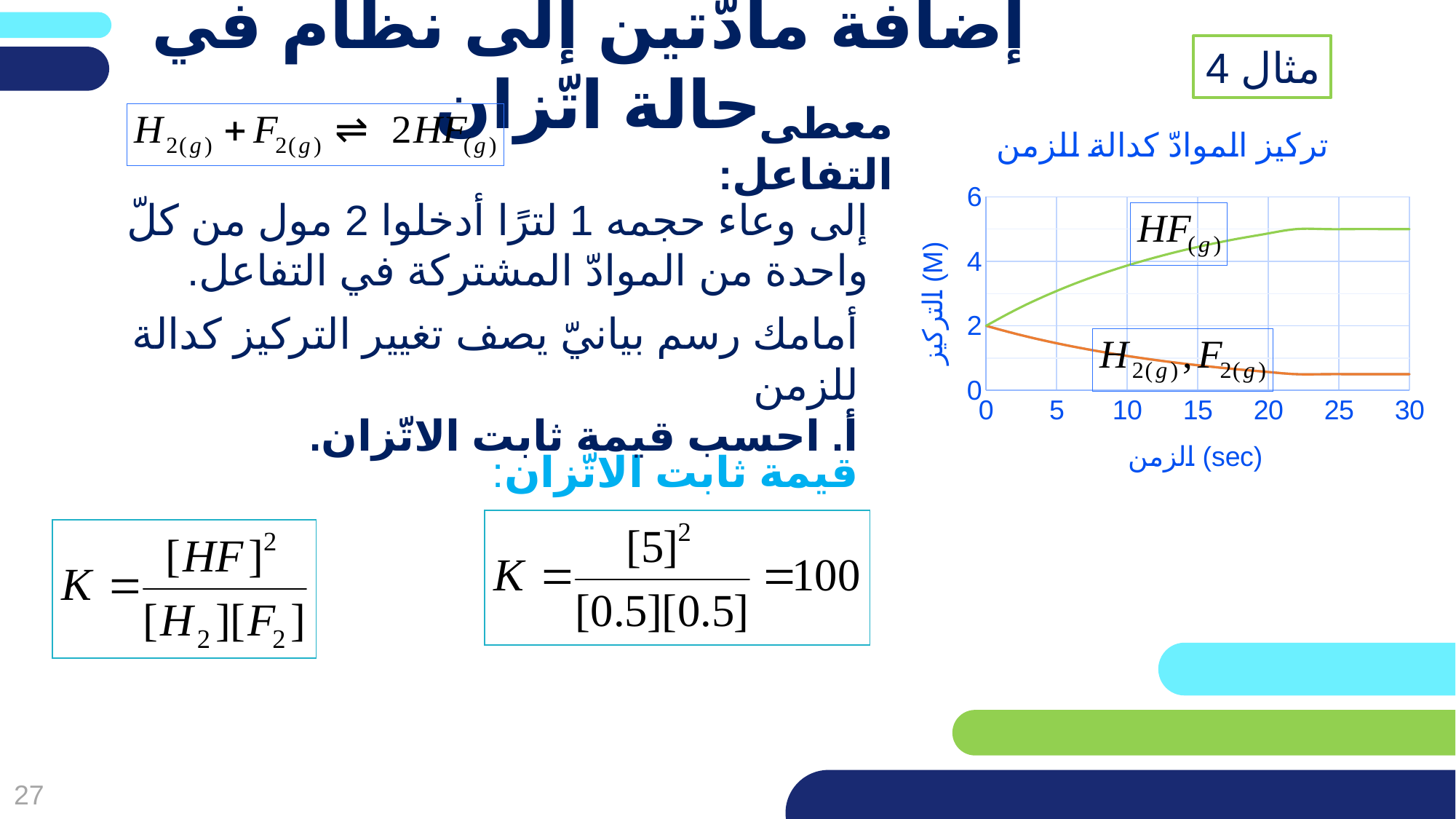
What is the concentration of H2(g), F2(g) at time 0 sec? 2 What is the title of the chart? تركيز الموادّ كدالة للزمن Is the concentration of HF(g) at 30 sec greater or less than 4? greater Does the concentration of HF(g) rise or fall as time increases? rise At 30 sec, which series has the higher concentration, HF(g) or H2(g), F2(g)? HF(g) What is the concentration of HF(g) at time 0 sec? 2 What kind of chart is shown on the slide? line chart How many series are plotted on the chart? 2 What is the label of the x axis of the chart? الزمن (sec) Does the concentration of H2(g), F2(g) rise or fall as time increases? fall At 10 sec, which series has the lower concentration, HF(g) or H2(g), F2(g)? H2(g), F2(g) Is the concentration of H2(g), F2(g) at 30 sec greater or less than 2? less